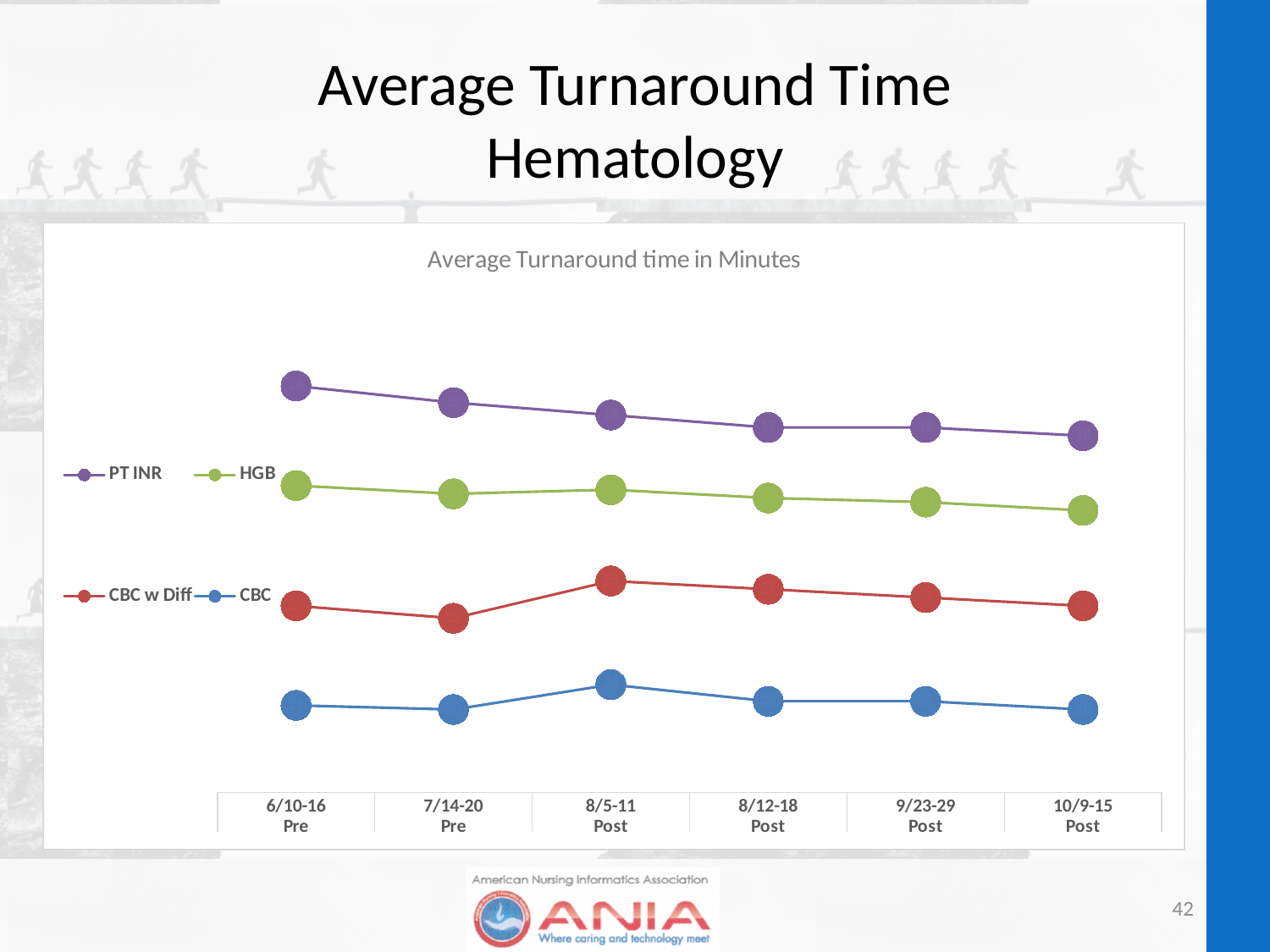
How many series does the legend list? 4 Does the HGB line rise or fall from 6/10-16 Pre to 10/9-15 Post? fall How many time periods are plotted along the x axis? 6 What is the title shown inside the chart area? Average Turnaround time in Minutes How many of the x-axis periods are labelled Post? 4 Does the PT INR line rise or fall from 6/10-16 Pre to 10/9-15 Post? fall What kind of chart is shown on the slide? line chart Which series is drawn in blue? CBC